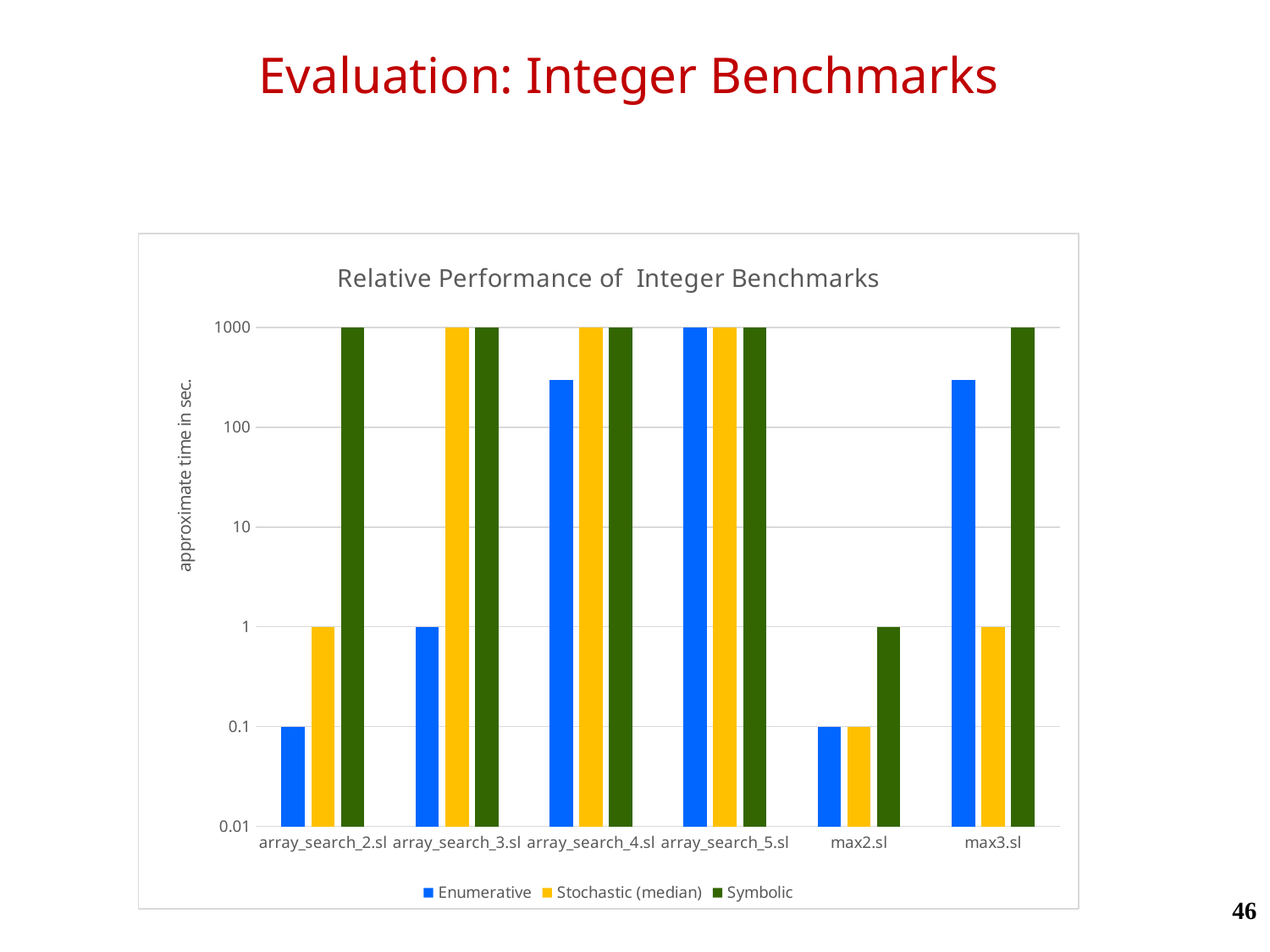
For array_search_2.sl, which is larger: the Enumerative value or the Symbolic value? Symbolic What kind of chart is shown on the slide? bar chart For the Symbolic series, which benchmark has the lowest value? max2.sl What is the Symbolic value for max2.sl? 1 What is the Stochastic (median) value for max3.sl? 1 What is the Symbolic value for array_search_2.sl? 1000 What is the label on the y axis? approximate time in sec. How many series does the legend list? 3 Is the Enumerative value for array_search_4.sl greater or less than 100? greater How many benchmark categories are shown on the x axis? 6 Is the Enumerative value for max3.sl greater or less than 1000? less What is the Enumerative value for max2.sl? 0.1